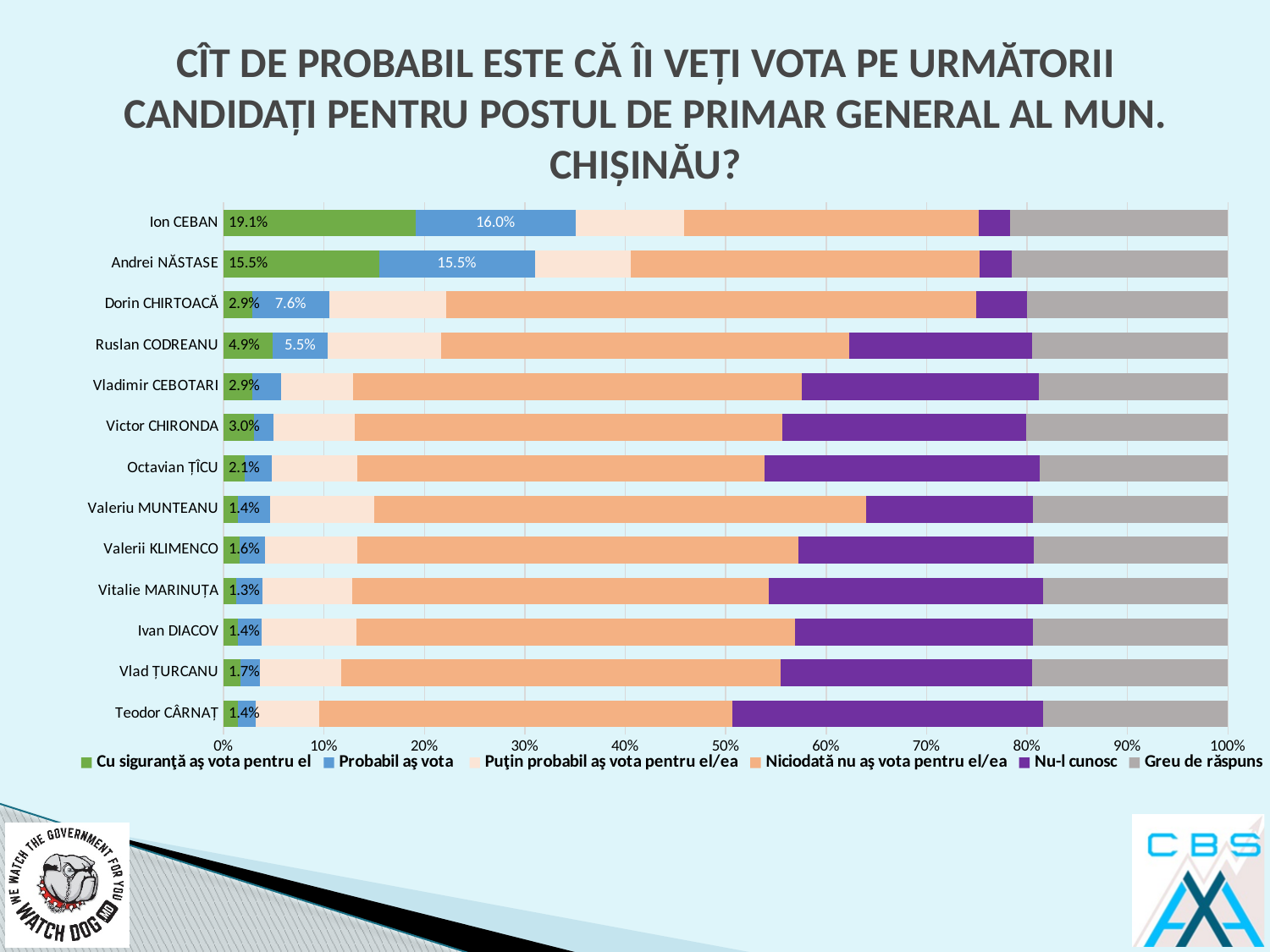
Who has the larger 'Cu siguranță aș vota pentru el' value, Ruslan CODREANU or Dorin CHIRTOACĂ? Ruslan CODREANU What is the 'Probabil aș vota' value for Ruslan CODREANU? 5.5% What is the difference between Ion CEBAN's and Andrei NĂSTASE's 'Cu siguranță aș vota pentru el' values? 3.6 percentage points Which candidate has the lowest 'Cu siguranță aș vota pentru el' value? Vitalie MARINUȚA How many series does the legend list? 6 What is the 'Probabil aș vota' value for Dorin CHIRTOACĂ? 7.6% Which colour represents the 'Nu-l cunosc' series in the legend? Purple What kind of chart is shown on the slide? Bar chart Which candidate has the highest 'Cu siguranță aș vota pentru el' value? Ion CEBAN What is the 'Cu siguranță aș vota pentru el' value for Ion CEBAN? 19.1% How many candidates are listed on the chart? 13 What is the 'Probabil aș vota' value for Andrei NĂSTASE? 15.5%